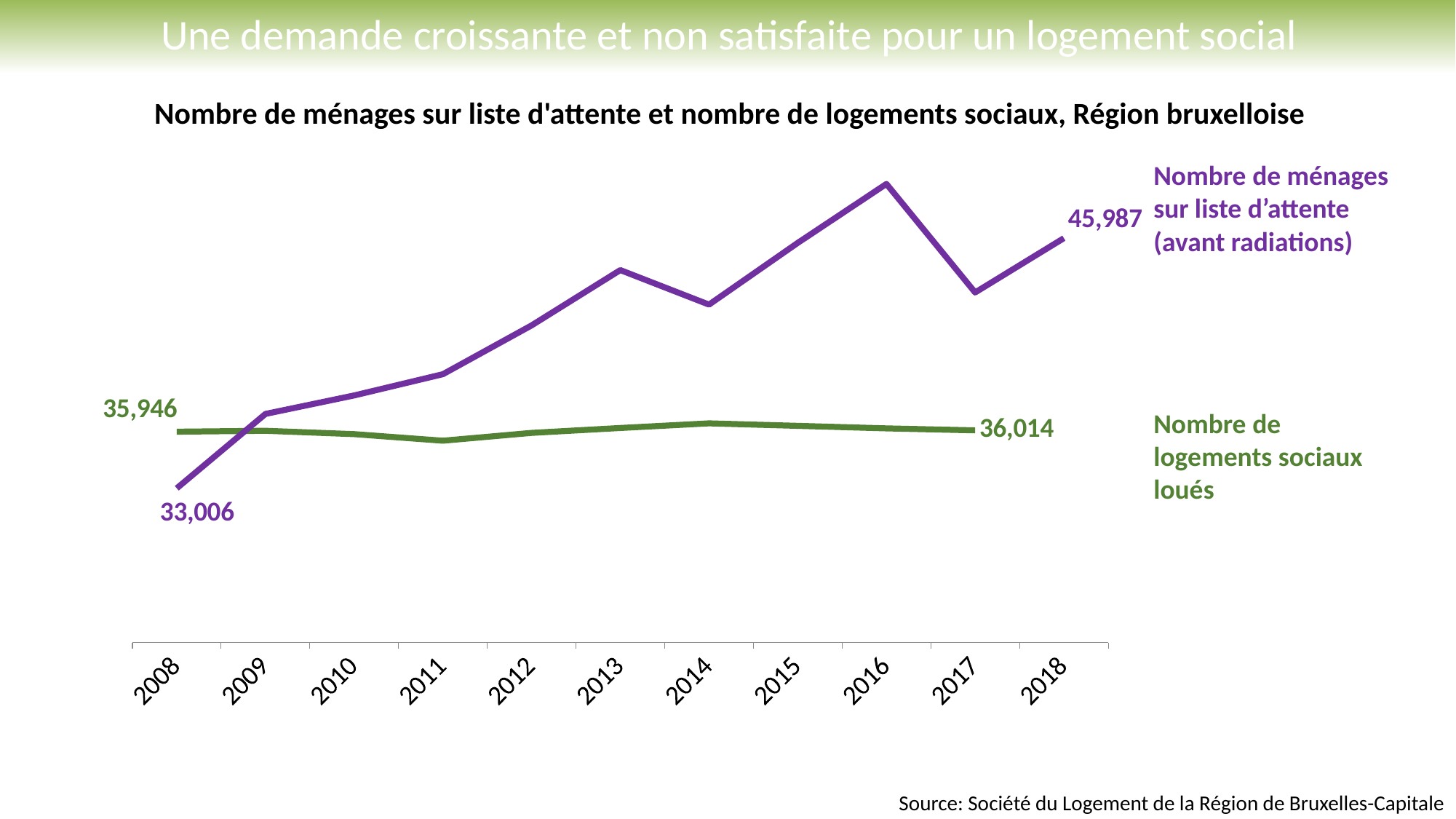
Overall, does the number of households on the waiting list rise or fall from 2008 to 2018? Rise By how much did the number of households on the waiting list increase between 2008 and 2018? 12,981 What is the number of households on the waiting list (Nombre de ménages sur liste d'attente) in 2018? 45,987 What is the number of households on the waiting list (Nombre de ménages sur liste d'attente) in 2008? 33,006 In which year is the number of households on the waiting list lowest? 2008 What type of chart is shown on the slide? Line chart In 2008, which was larger: the number of households on the waiting list or the number of social housing units rented? Number of social housing units rented How many years are shown on the x axis of the chart? 11 What is the number of social housing units rented (Nombre de logements sociaux loués) in 2017? 36,014 What is the difference between the number of social housing units rented in 2017 and in 2008? 68 In which year does the number of households on the waiting list reach its highest point? 2016 What is the number of social housing units rented (Nombre de logements sociaux loués) in 2008? 35,946